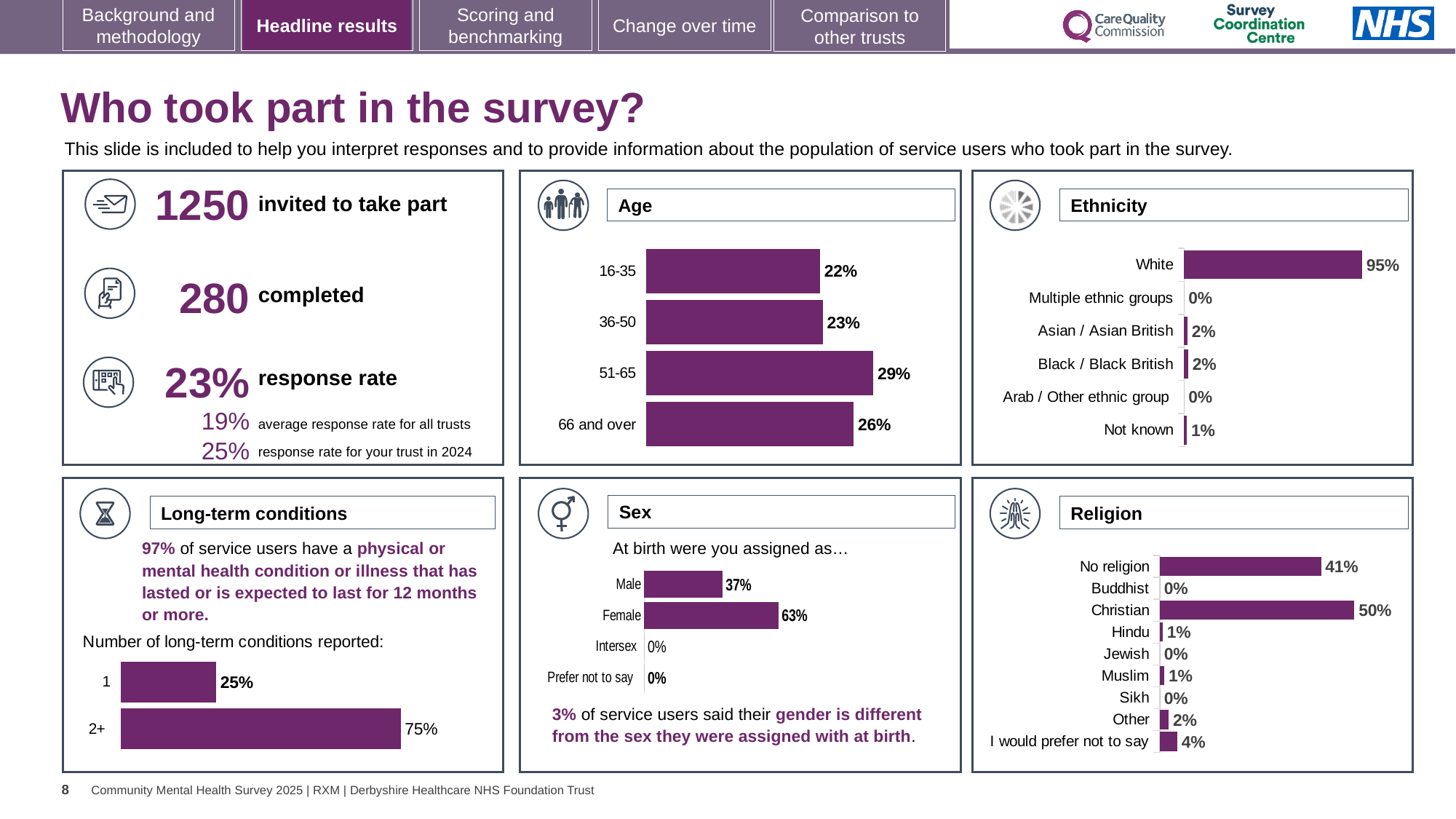
In the Sex chart, what percentage of respondents were assigned Female at birth? 63% In the Religion chart, what percentage of respondents said they would prefer not to say? 4% In the Age chart, which age group has the lowest percentage? 16-35 In the Ethnicity chart, what percentage of respondents were White? 95% In the Sex chart, which is larger, Male or Female? Female What type of chart is used in the Age panel? Bar chart In the Long-term conditions chart, what percentage of service users reported 2+ conditions? 75% In the Age chart, what percentage of respondents were aged 51-65? 29% How many categories are shown in the Ethnicity chart? 6 In the Religion chart, which category has the highest percentage? Christian In the Sex chart, what is the difference between Female and Male? 26% In the Age chart, what is the difference between the 66 and over group and the 36-50 group? 3%